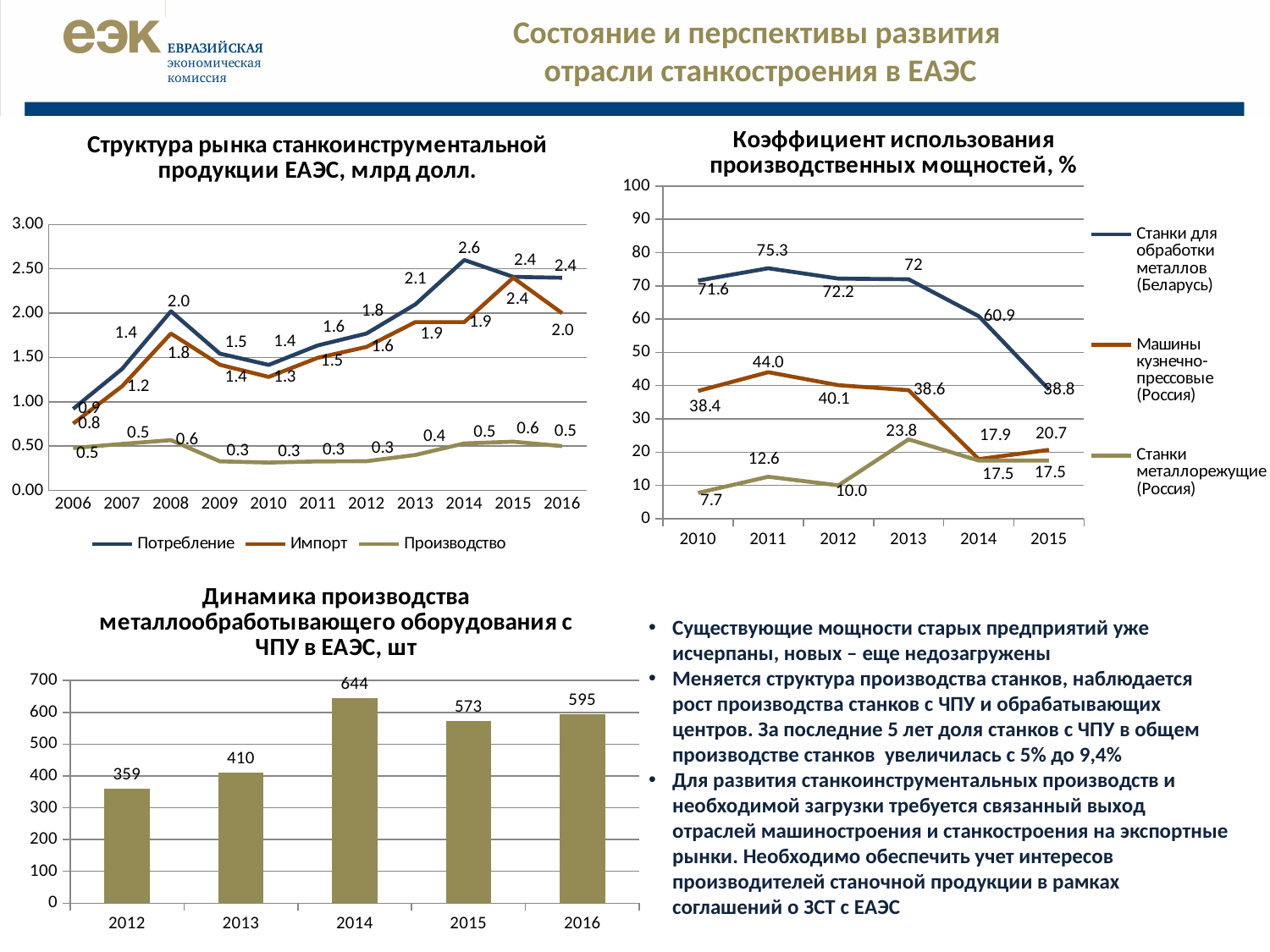
How many series does the legend list in the chart 'Структура рынка станкоинструментальной продукции ЕАЭС, млрд долл.'? 3 In the chart 'Динамика производства металлообрабатывающего оборудования с ЧПУ в ЕАЭС, шт', what is the value for 2014? 644 In the chart 'Коэффициент использования производственных мощностей, %', what is the difference between the 2013 and 2015 values for Станки для обработки металлов (Беларусь)? 33.2 In the chart 'Коэффициент использования производственных мощностей, %', what is the value for Станки для обработки металлов (Беларусь) in 2011? 75.3 How many years are shown in the chart 'Динамика производства металлообрабатывающего оборудования с ЧПУ в ЕАЭС, шт'? 5 In the chart 'Структура рынка станкоинструментальной продукции ЕАЭС, млрд долл.', what is the value of Потребление in 2014? 2.6 What kind of chart is 'Динамика производства металлообрабатывающего оборудования с ЧПУ в ЕАЭС, шт'? Bar chart In the chart 'Структура рынка станкоинструментальной продукции ЕАЭС, млрд долл.', which is larger in 2016: Потребление or Производство? Потребление In the chart 'Динамика производства металлообрабатывающего оборудования с ЧПУ в ЕАЭС, шт', which year has the lowest value? 2012 In the chart 'Коэффициент использования производственных мощностей, %', does the value for Станки для обработки металлов (Беларусь) rise or fall from 2013 to 2015? Fall In the chart 'Структура рынка станкоинструментальной продукции ЕАЭС, млрд долл.', what is the value of Импорт in 2015? 2.4 In the chart 'Динамика производства металлообрабатывающего оборудования с ЧПУ в ЕАЭС, шт', what is the difference between the 2016 and 2015 values? 22